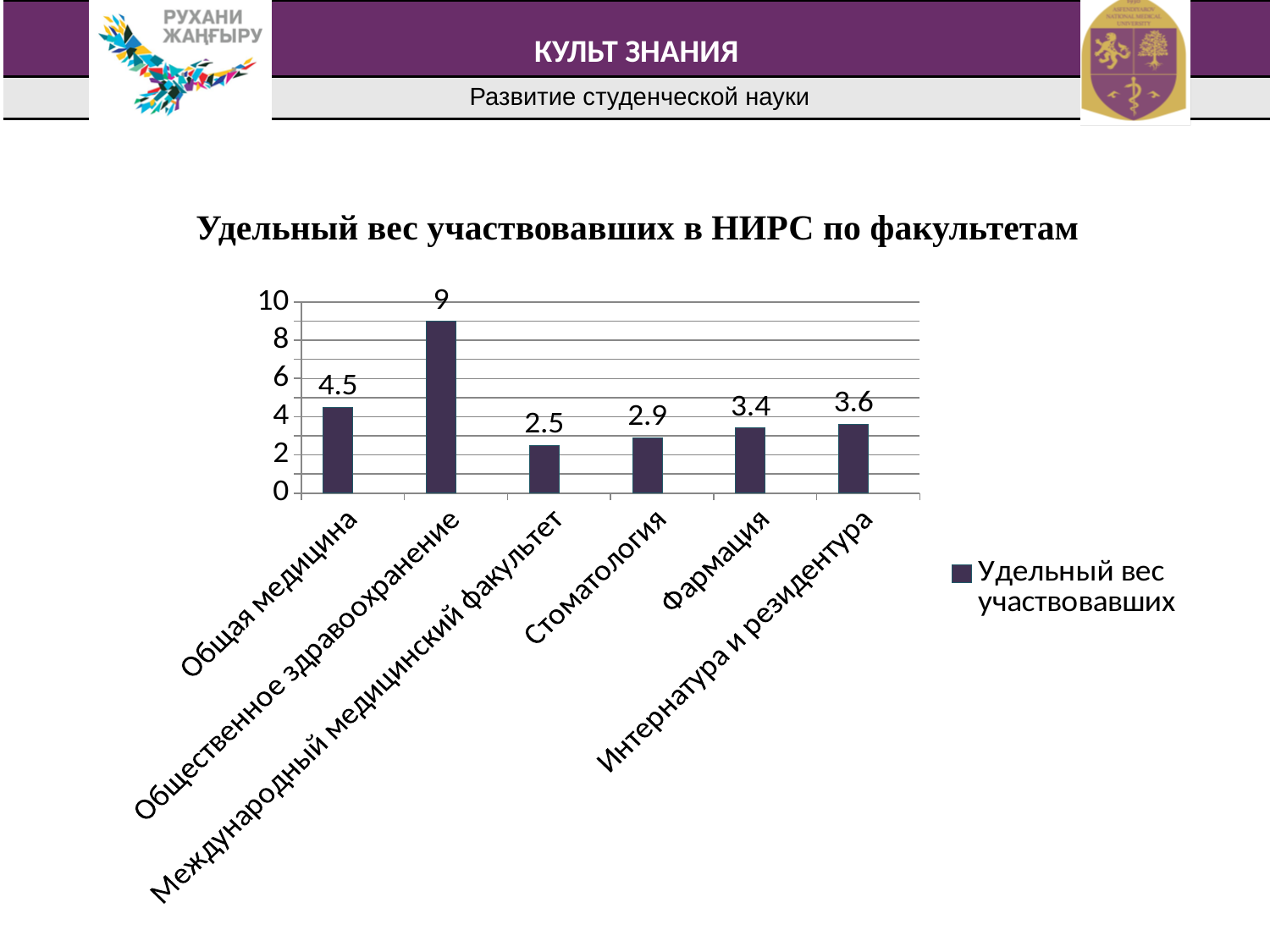
What is the value for Общая медицина? 4.5 Which faculty has the highest value? Общественное здравоохранение What is the difference between the values for Общественное здравоохранение and Общая медицина? 4.5 What is the value for Стоматология? 2.9 What is the value for Общественное здравоохранение? 9 How many faculties are shown on the chart? 6 What is the title of the chart? Удельный вес участвовавших в НИРС по факультетам What kind of chart is shown on the slide? Bar chart Which faculty has the lowest value? Международный медицинский факультет What is the value for Международный медицинский факультет? 2.5 Which is larger, the value for Фармация or the value for Интернатура и резидентура? Интернатура и резидентура What is the value for Фармация? 3.4